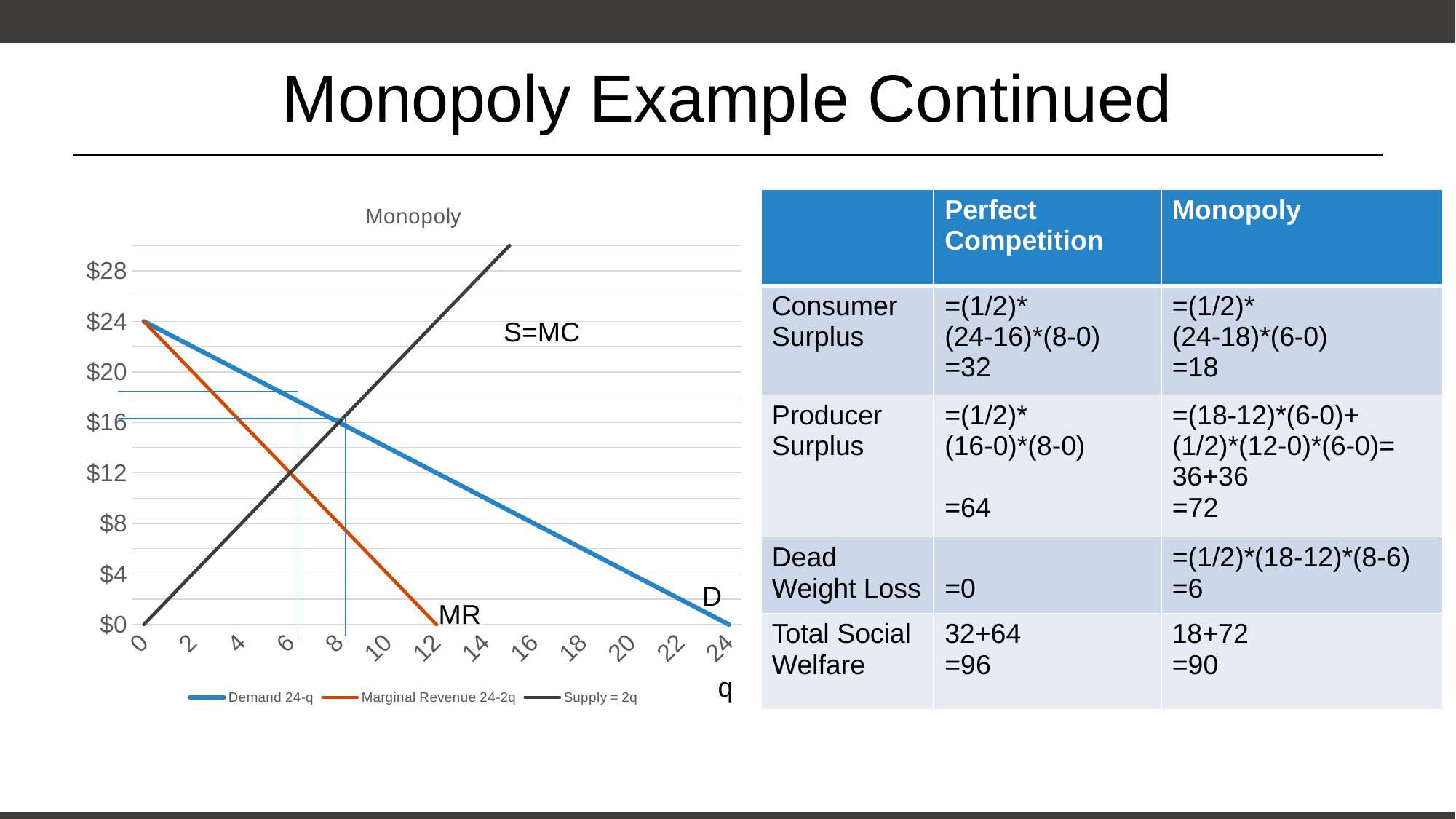
At what quantity do the Demand 24-q and Supply = 2q lines intersect? 8 What is the value of the Demand 24-q line at q = 24? $0 How many series does the chart legend list? 3 Does the Supply = 2q line rise or fall as q increases? rise What is the title of the chart? Monopoly Which series is drawn in orange in the chart? Marginal Revenue 24-2q What is the value of the Marginal Revenue 24-2q line at q = 12? $0 Does the Demand 24-q line rise or fall as q increases? fall Is the value of the Supply = 2q line at q = 12 greater or less than $20? greater What is the value of the Demand 24-q line at q = 0? $24 At what price do the Demand 24-q and Supply = 2q lines intersect? $16 What kind of chart is shown on the slide? line chart